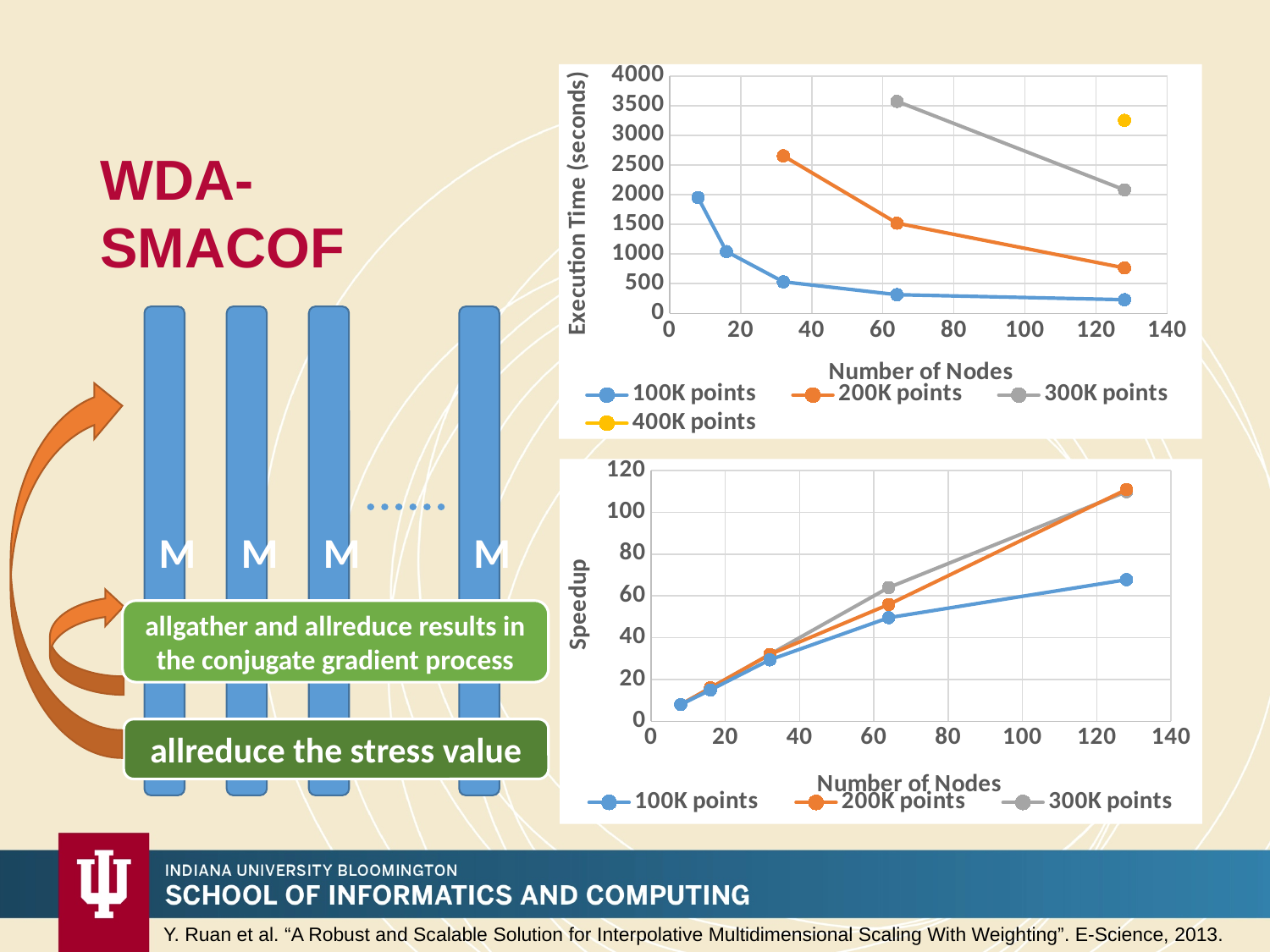
In the top chart (Execution Time), at 64 nodes, which is larger: the value for 200K points or for 100K points? 200K points In the top chart (Execution Time), how many series does the legend list? 4 In the top chart, what is the label of the vertical axis? Execution Time (seconds) In the top chart (Execution Time), is the value for 300K points at 64 nodes greater or less than 3000? greater In the bottom chart (Speedup), how many series does the legend list? 3 In the top chart (Execution Time), is the value for 100K points at 8 nodes greater or less than 1500? greater In the bottom chart (Speedup), does the speedup for 200K points rise or fall as the number of nodes increases? rise In the top chart (Execution Time), which series has the highest execution time at 128 nodes? 400K points What kind of chart is the top chart (Execution Time vs Number of Nodes)? line chart In the top chart (Execution Time), does the execution time for 100K points rise or fall as the number of nodes increases? fall In the bottom chart (Speedup), is the value for 200K points at 128 nodes greater or less than 100? greater